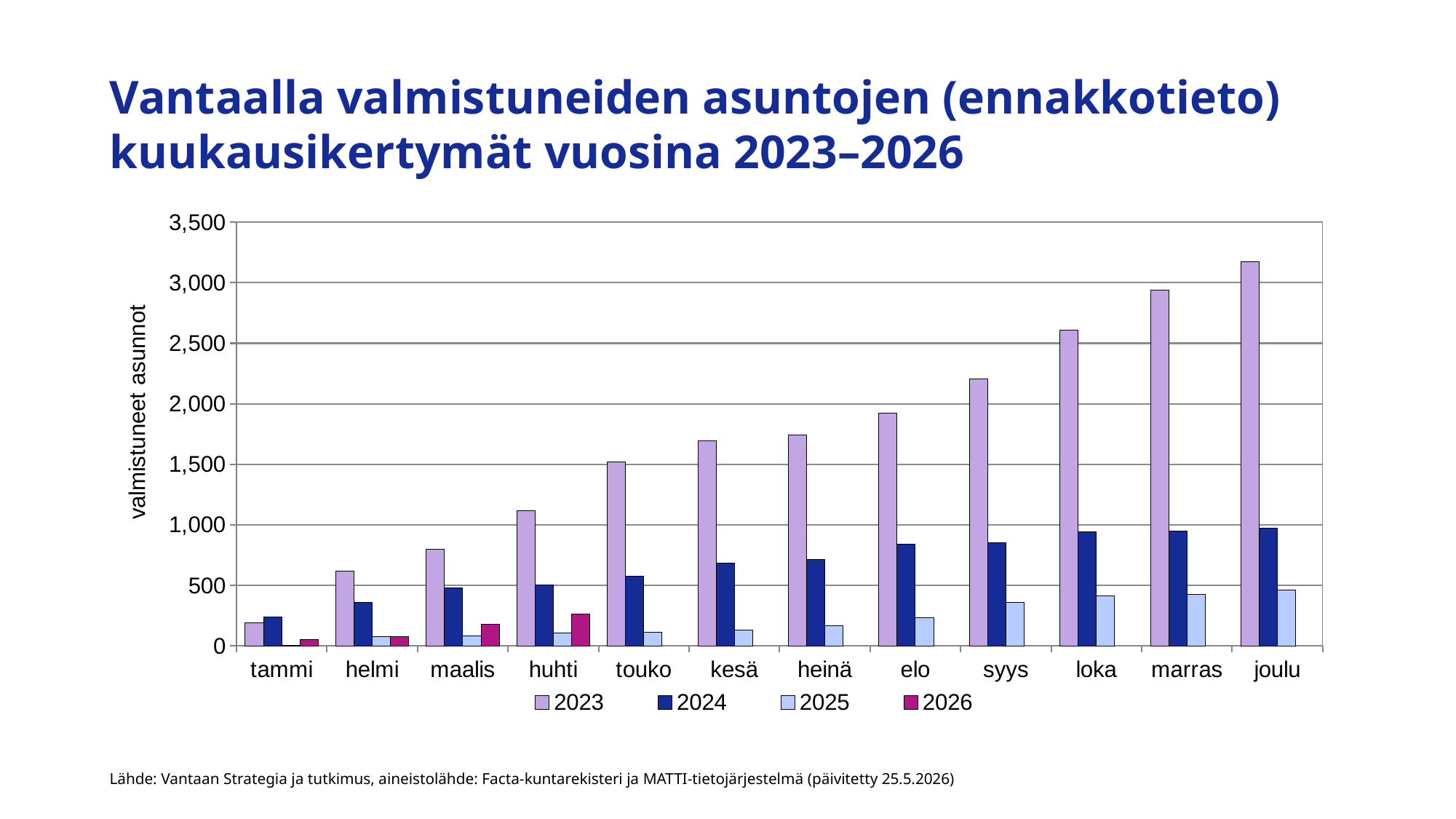
Is the value for 2023 in loka greater or less than 2,500? greater Do the values for the 2023 series rise or fall from tammi to joulu? rise How many months are shown on the x axis? 12 What kind of chart is shown on the slide? bar chart Which month has the highest value for the 2023 series? joulu In touko, which series has the larger value, 2023 or 2024? 2023 Which month has the lowest value for the 2023 series? tammi Is the value for 2025 in syys greater or less than 500? less For how many months does the 2026 series have a bar? 4 How many series does the legend list? 4 Is the value for 2023 in joulu greater or less than 3,000? greater